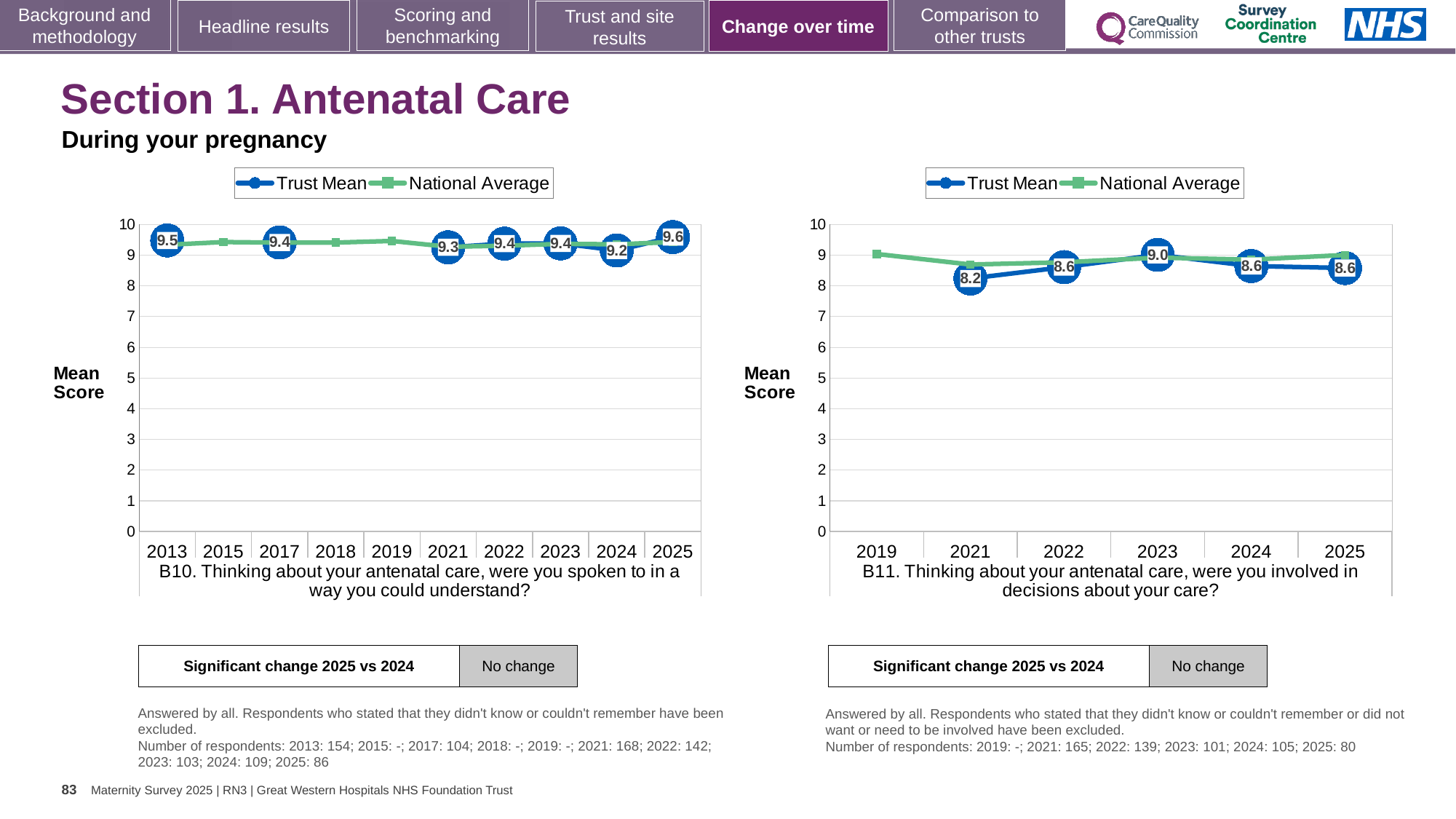
What kind of chart is the B10 chart on the left? Line chart In the B11 chart on the right, what is the difference between the Trust Mean for 2023 and the Trust Mean for 2021? 0.8 In the B11 chart on the right, what is the Trust Mean for 2023? 9.0 How many years are shown on the x axis of the B10 chart on the left? 10 In the B10 chart on the left, what is the Trust Mean for 2025? 9.6 In the B10 chart on the left, which year has the highest Trust Mean? 2025 In the B11 chart on the right, which year has the lowest Trust Mean? 2021 In the B11 chart on the right, is the National Average for 2019 greater or less than 8? greater How many series does the legend of the B11 chart on the right list? 2 In the B11 chart on the right, what is the Trust Mean for 2021? 8.2 In the B10 chart on the left, what is the Trust Mean for 2024? 9.2 In the B10 chart on the left, is the Trust Mean higher in 2013 or in 2024? 2013